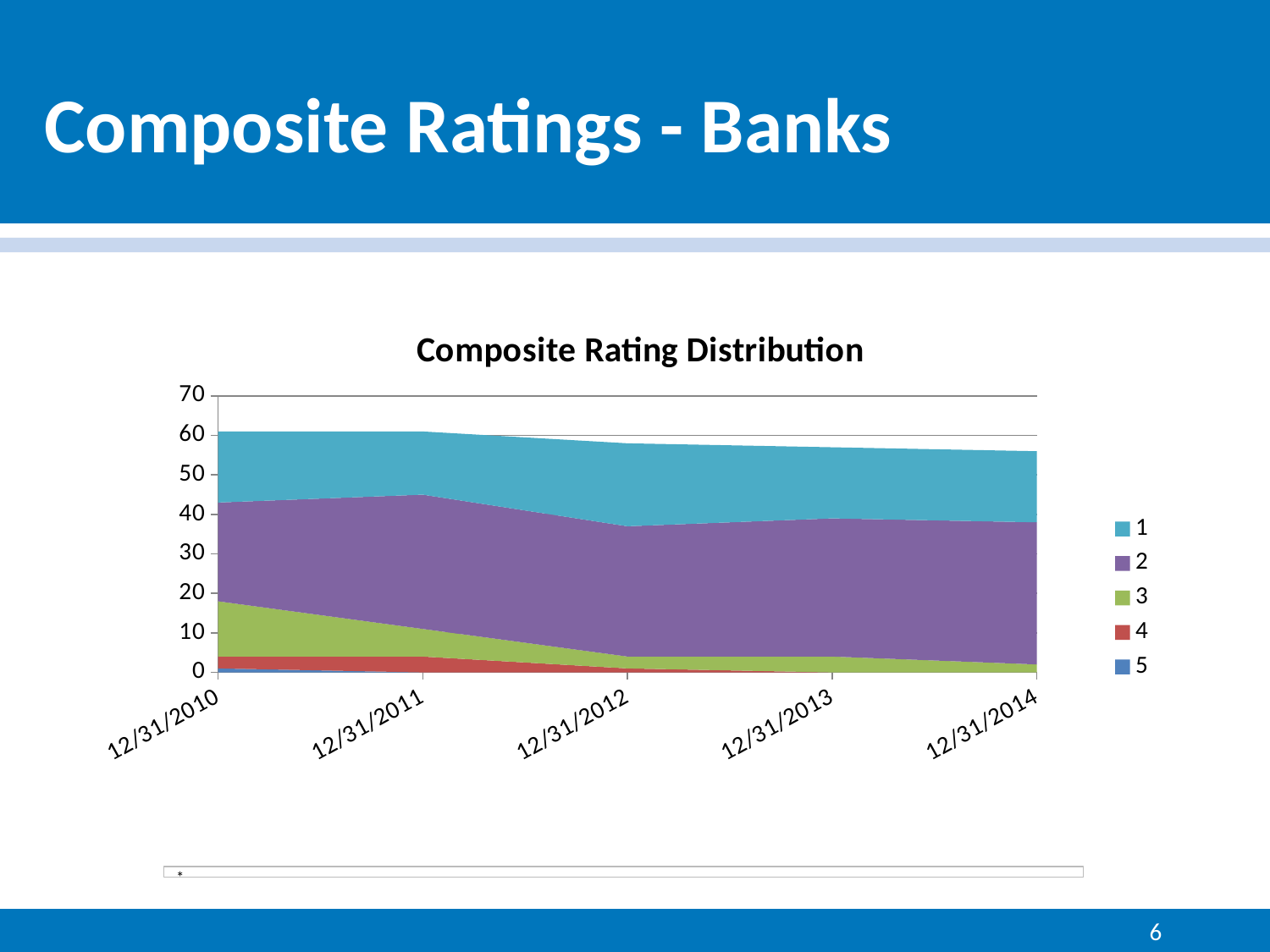
Does the total height of the stacked areas rise or fall from 12/31/2011 to 12/31/2014? fall Does the area for series 3 get larger or smaller from 12/31/2010 to 12/31/2014? smaller Is the total height of the stacked areas at 12/31/2013 greater or less than 40? greater Is the total height of the stacked areas at 12/31/2010 greater or less than 50? greater How many dates are shown along the x axis? 5 How many series does the legend list? 5 Is the total height of the stacked areas at 12/31/2012 greater or less than 70? less What is the first date shown on the x axis? 12/31/2010 What kind of chart is shown on the slide? Stacked area chart What is the title of the chart? Composite Rating Distribution Which series occupies the largest area of the chart at 12/31/2014, series 1 or series 3? Series 1